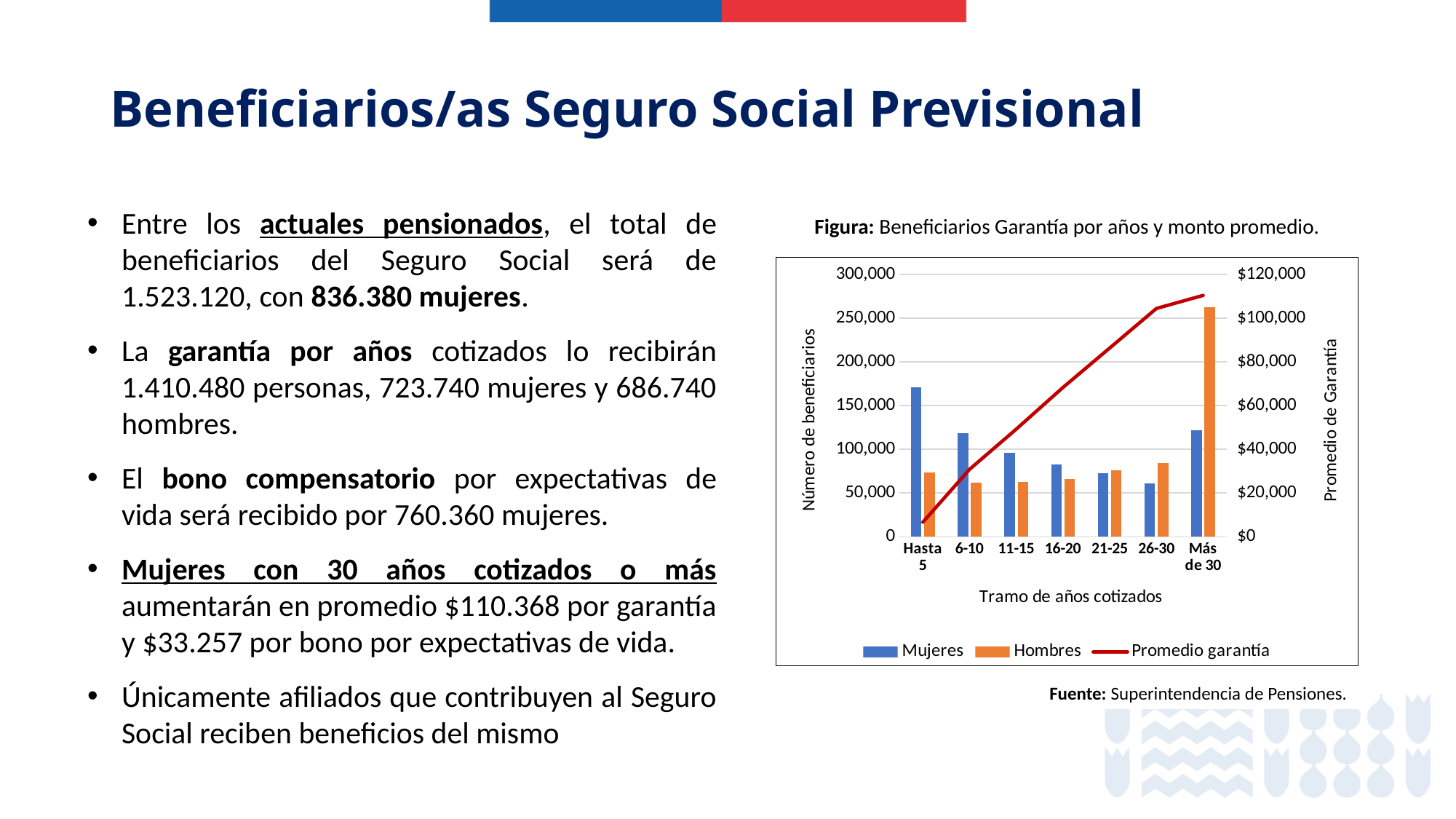
How many series does the legend list? 3 Which category has the highest value for Mujeres? Hasta 5 In the 'Hasta 5' category, which is larger, Mujeres or Hombres? Mujeres Does the 'Promedio garantía' line rise or fall as the years contributed increase along the x axis? It rises What is the title of the x axis of the chart? Tramo de años cotizados In the 'Más de 30' category, which is larger, Mujeres or Hombres? Hombres Is the value for Hombres in the 'Más de 30' category greater or less than 250,000? greater Which category has the highest value for Hombres? Más de 30 How many categories (tramos de años cotizados) are shown on the x axis? 7 Is the value for Mujeres in the 'Hasta 5' category greater or less than 150,000? greater What kind of chart is shown in the figure 'Beneficiarios Garantía por años y monto promedio'? A bar chart combined with a line chart Which category has the lowest value for Mujeres? 26-30